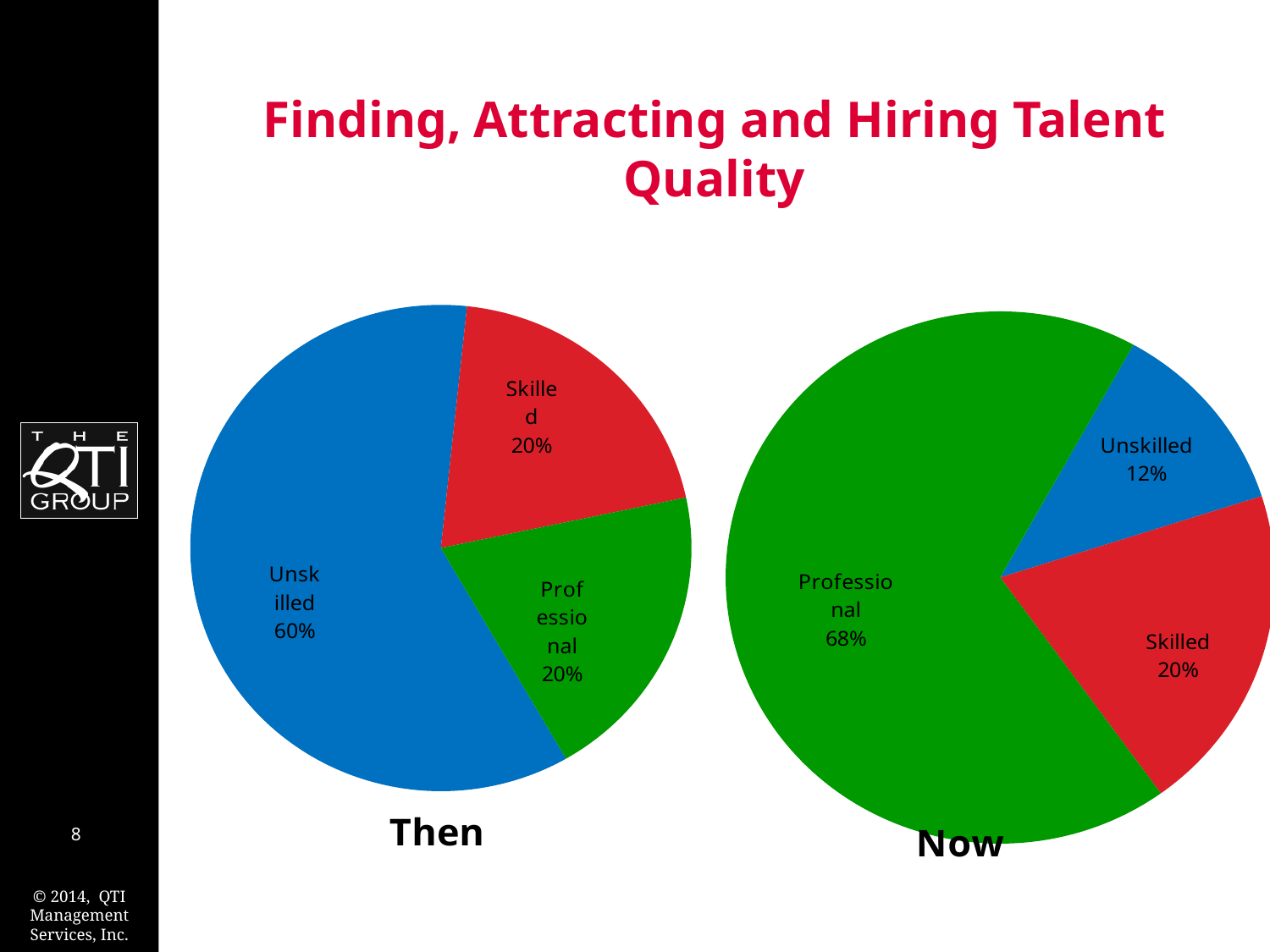
In the "Then" pie chart, which category has the largest share? Unskilled In the "Now" pie chart, what share is Professional? 68% How many slices does the "Then" pie chart have? 3 In the "Now" pie chart, what colour is the Professional slice? Green In the "Then" pie chart, what share is Skilled? 20% What type of chart is the "Now" chart? Pie chart In the "Now" pie chart, what share is Unskilled? 12% In the "Then" pie chart, what is the difference between the Unskilled share and the Professional share? 40% In the "Now" pie chart, what is the difference between the Professional share and the Skilled share? 48% In the "Then" pie chart, what share is Unskilled? 60% In the "Now" pie chart, which category has the smallest share? Unskilled In the "Now" pie chart, which is larger, Skilled or Unskilled? Skilled